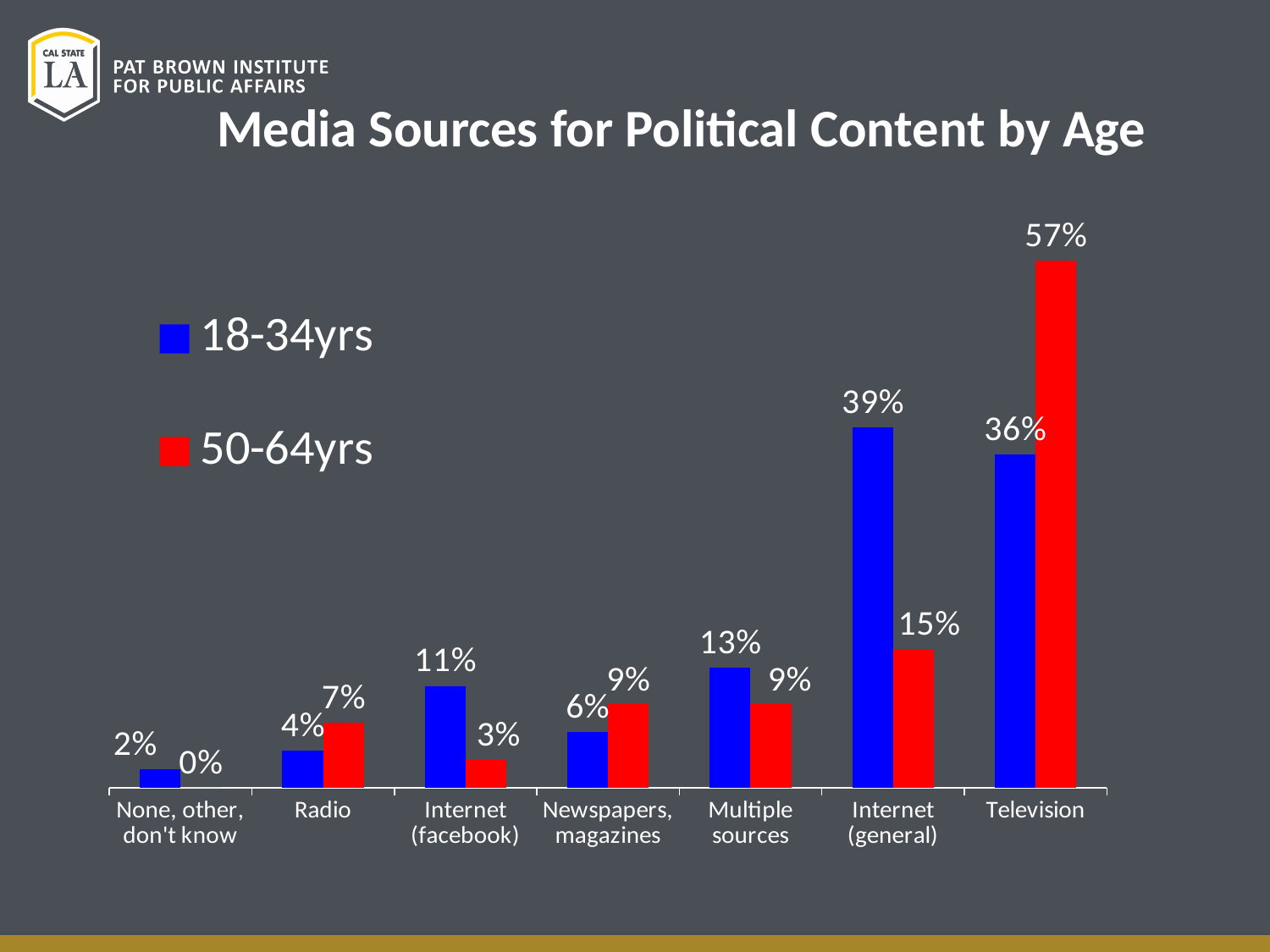
What percentage of 18-34yrs use Internet (general) as a media source for political content? 39% How many categories are shown on the x axis? 7 Which category has the highest value for the 18-34yrs series? Internet (general) What type of chart is shown on the slide? Bar chart What is the value for 50-64yrs in the Internet (facebook) category? 3% What percentage of 50-64yrs use Television as a media source for political content? 57% What is the title of the chart? Media Sources for Political Content by Age How many series does the legend list? 2 Which category has the lowest value for the 50-64yrs series? None, other, don't know Which age group has the larger value for Internet (facebook)? 18-34yrs Which age group has the larger value for Radio? 50-64yrs What is the difference between the 50-64yrs and 18-34yrs values for Television? 21%